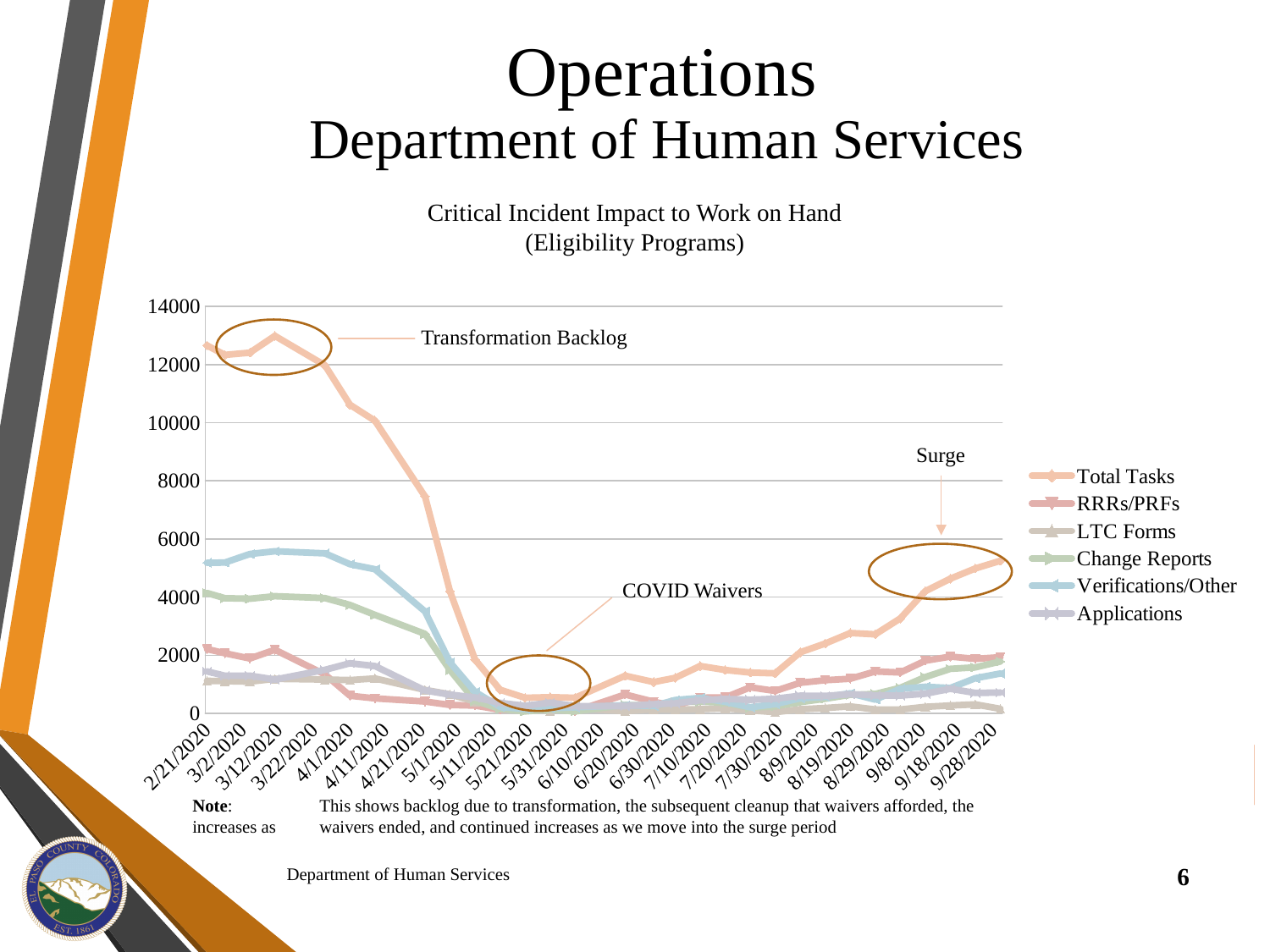
What annotation labels the circled region at the start of the Total Tasks line? Transformation Backlog Is the value for Total Tasks on 5/21/2020 greater or less than 2000? less Is the value for Total Tasks on 9/28/2020 greater or less than 4000? greater How many series does the legend list? 6 What is the title of the chart? Critical Incident Impact to Work on Hand (Eligibility Programs) Is the value for Verifications/Other on 3/12/2020 greater or less than 4000? greater On 2/21/2020, which is larger: Verifications/Other or Change Reports? Verifications/Other Which series has the highest value on 2/21/2020? Total Tasks What kind of chart is shown on the slide? line chart Does the Total Tasks series rise or fall between 3/22/2020 and 5/21/2020? fall Does the Total Tasks series rise or fall between 7/30/2020 and 9/28/2020? rise